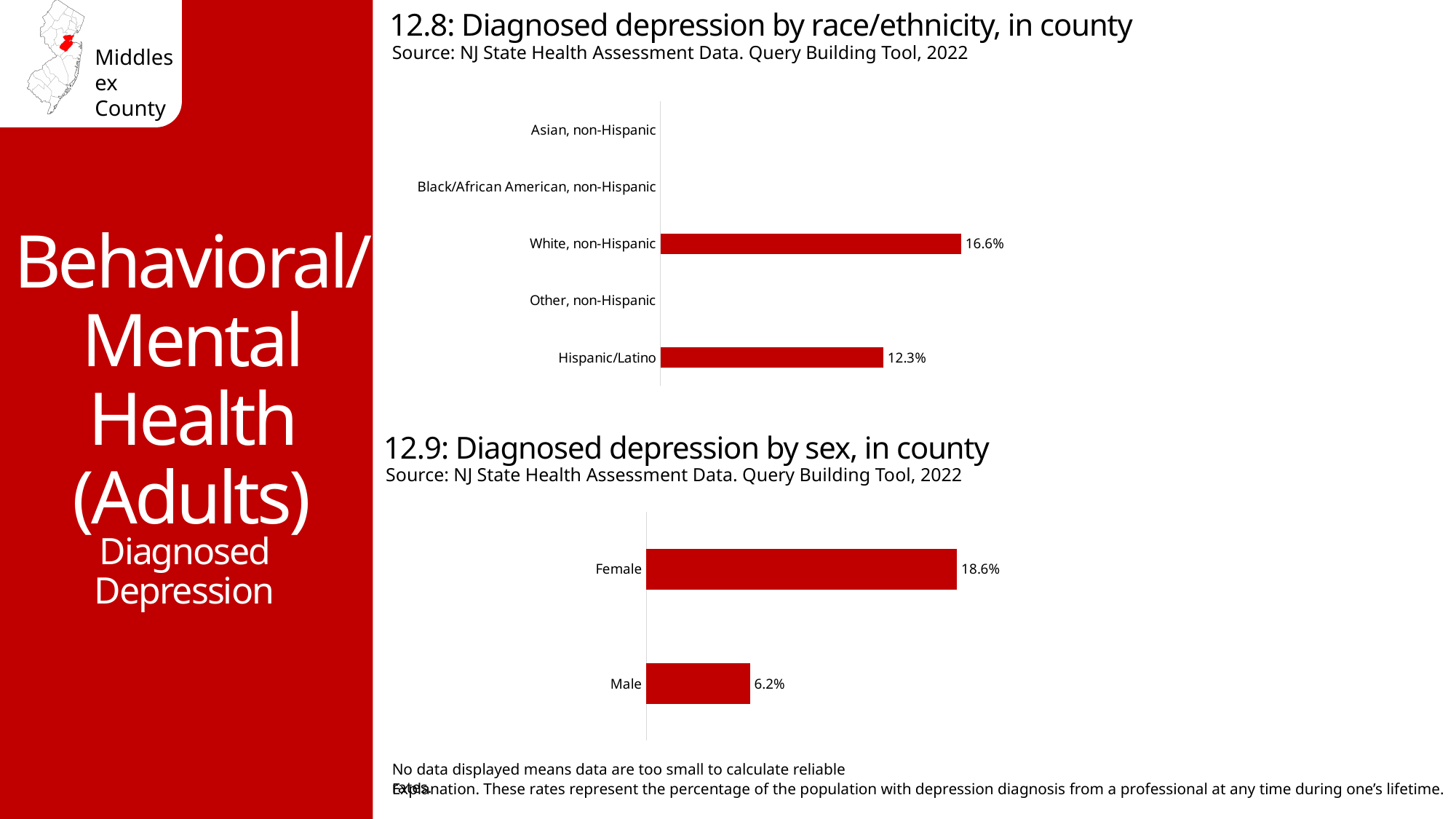
In the chart '12.9: Diagnosed depression by sex, in county', what is the difference between the Female and Male values? 12.4% In the chart '12.8: Diagnosed depression by race/ethnicity, in county', what is the value for White, non-Hispanic? 16.6% In the chart '12.8: Diagnosed depression by race/ethnicity, in county', how many categories have a bar displayed? 2 In the chart '12.8: Diagnosed depression by race/ethnicity, in county', how many race/ethnicity categories are listed on the axis? 5 In the chart '12.9: Diagnosed depression by sex, in county', how many categories are shown? 2 In the chart '12.9: Diagnosed depression by sex, in county', what is the value for Female? 18.6% In the chart '12.8: Diagnosed depression by race/ethnicity, in county', which has the larger value, White, non-Hispanic or Hispanic/Latino? White, non-Hispanic In the chart '12.9: Diagnosed depression by sex, in county', what is the value for Male? 6.2% In the chart '12.8: Diagnosed depression by race/ethnicity, in county', what is the value for Hispanic/Latino? 12.3% What kind of chart is '12.8: Diagnosed depression by race/ethnicity, in county'? Bar chart In the chart '12.8: Diagnosed depression by race/ethnicity, in county', what is the difference between the White, non-Hispanic and Hispanic/Latino values? 4.3% In the chart '12.9: Diagnosed depression by sex, in county', which category has the highest value? Female